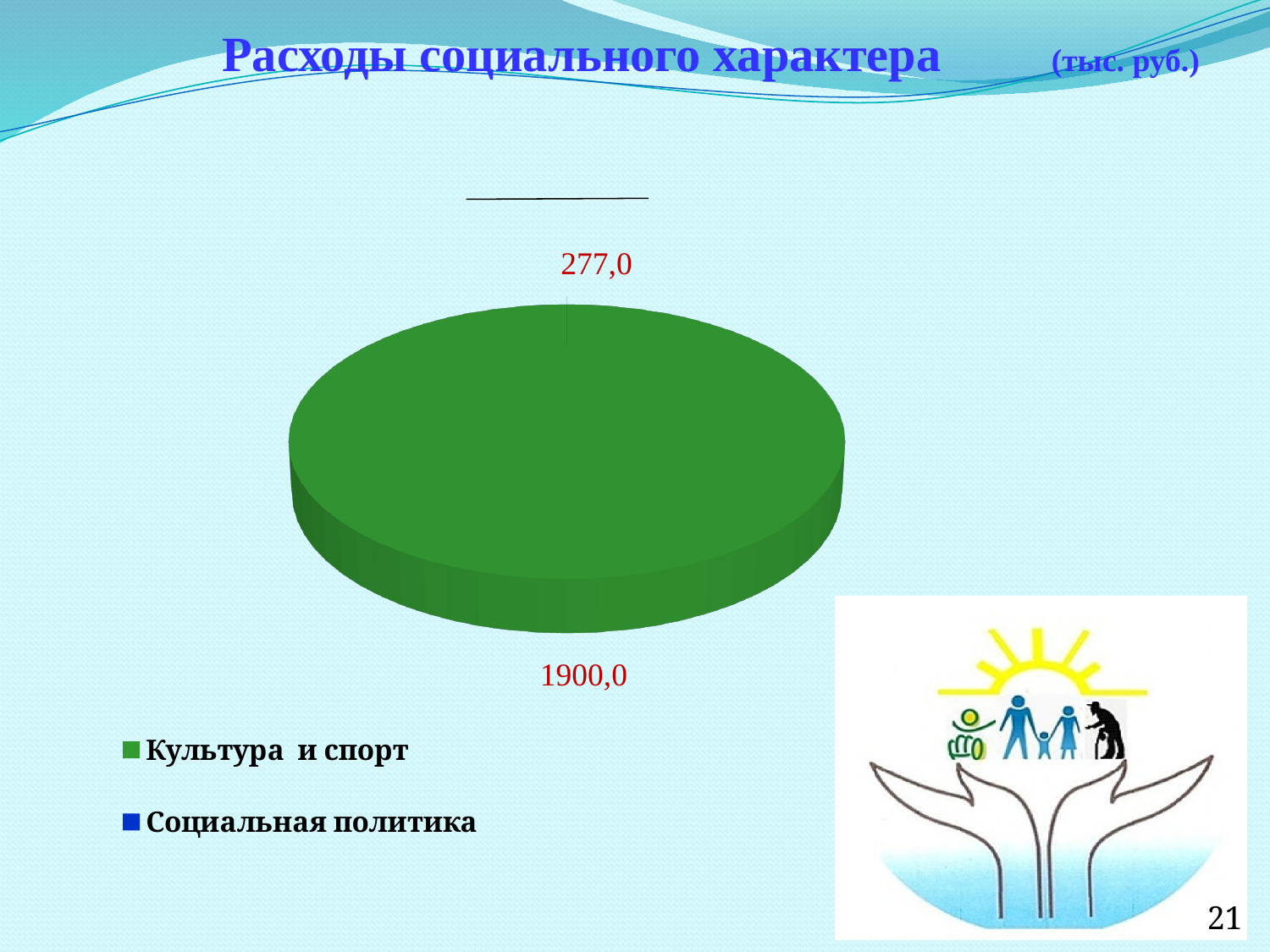
Is the largest value printed on the pie chart greater or less than 1000? greater What is the smallest value printed on the pie chart? 277,0 What colour is the legend marker for "Культура и спорт"? green What is the largest value printed on the pie chart? 1900,0 How many categories does the legend of the pie chart list? 2 Which of the two printed values on the pie chart is larger, 277,0 or 1900,0? 1900,0 What is the total of the two values printed on the pie chart? 2177,0 What value label is printed above the pie chart? 277,0 What is the title of the chart on the slide? Расходы социального характера (тыс. руб.) What kind of chart is shown on the slide? pie chart What is the difference between the two values printed on the pie chart, 1900,0 and 277,0? 1623,0 What value label is printed below the pie chart? 1900,0